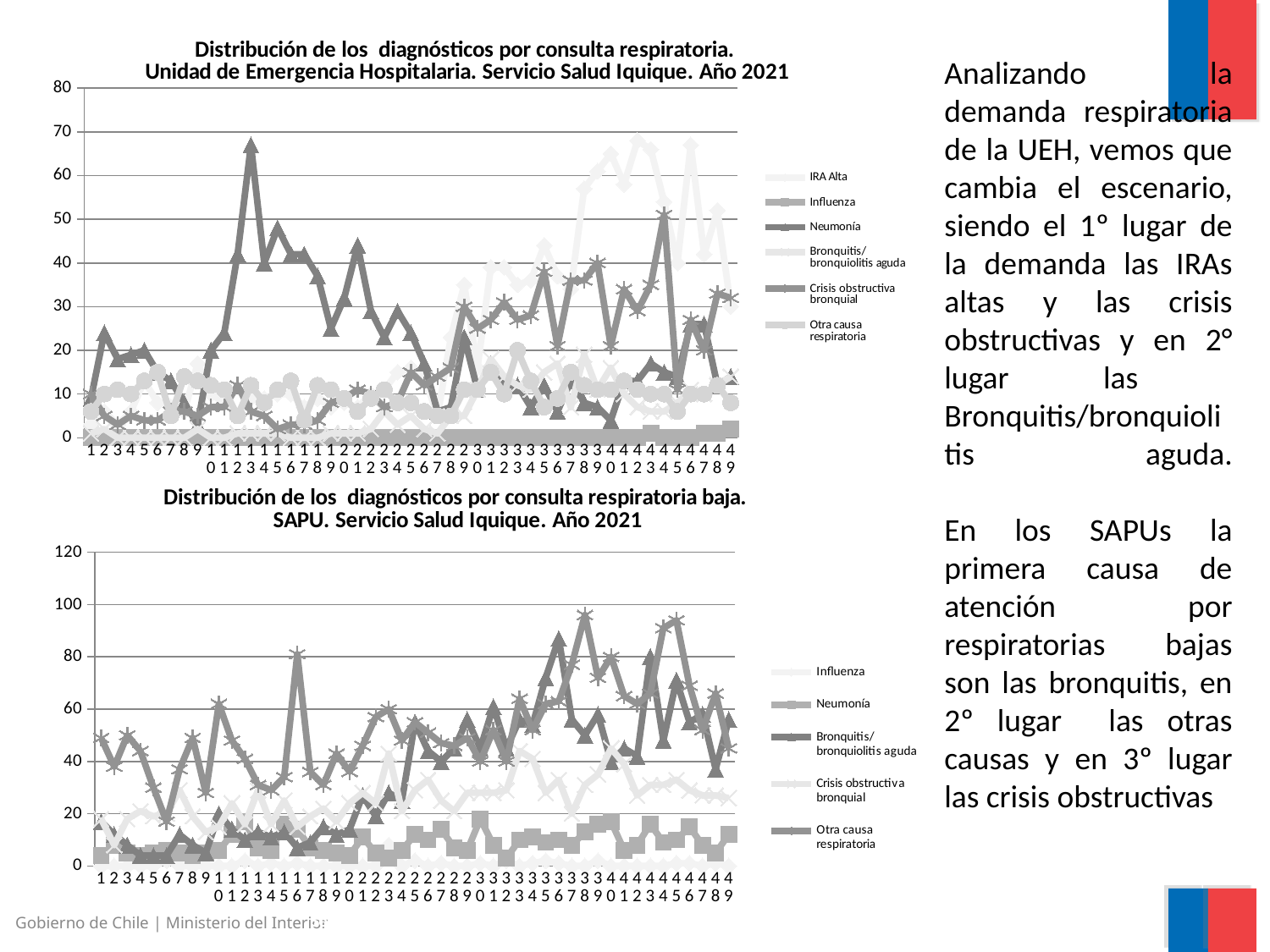
What kind of chart is the bottom chart, 'Distribución de los diagnósticos por consulta respiratoria baja. SAPU'? Line chart What is the highest value shown on the y axis of the bottom chart (SAPU)? 120 Which series appears first in the legend of the top chart (Unidad de Emergencia Hospitalaria)? IRA Alta How many series does the legend of the bottom chart (SAPU) list? 5 In the bottom chart (SAPU), is the value for Influenza at week 40 greater or less than 20? less How many weeks are plotted along the x axis of the bottom chart (SAPU)? 49 In the top chart (Unidad de Emergencia Hospitalaria), is the value for Influenza at week 49 greater or less than 10? less What kind of chart is the top chart, 'Distribución de los diagnósticos por consulta respiratoria. Unidad de Emergencia Hospitalaria'? Line chart How many series does the legend of the top chart (Unidad de Emergencia Hospitalaria) list? 6